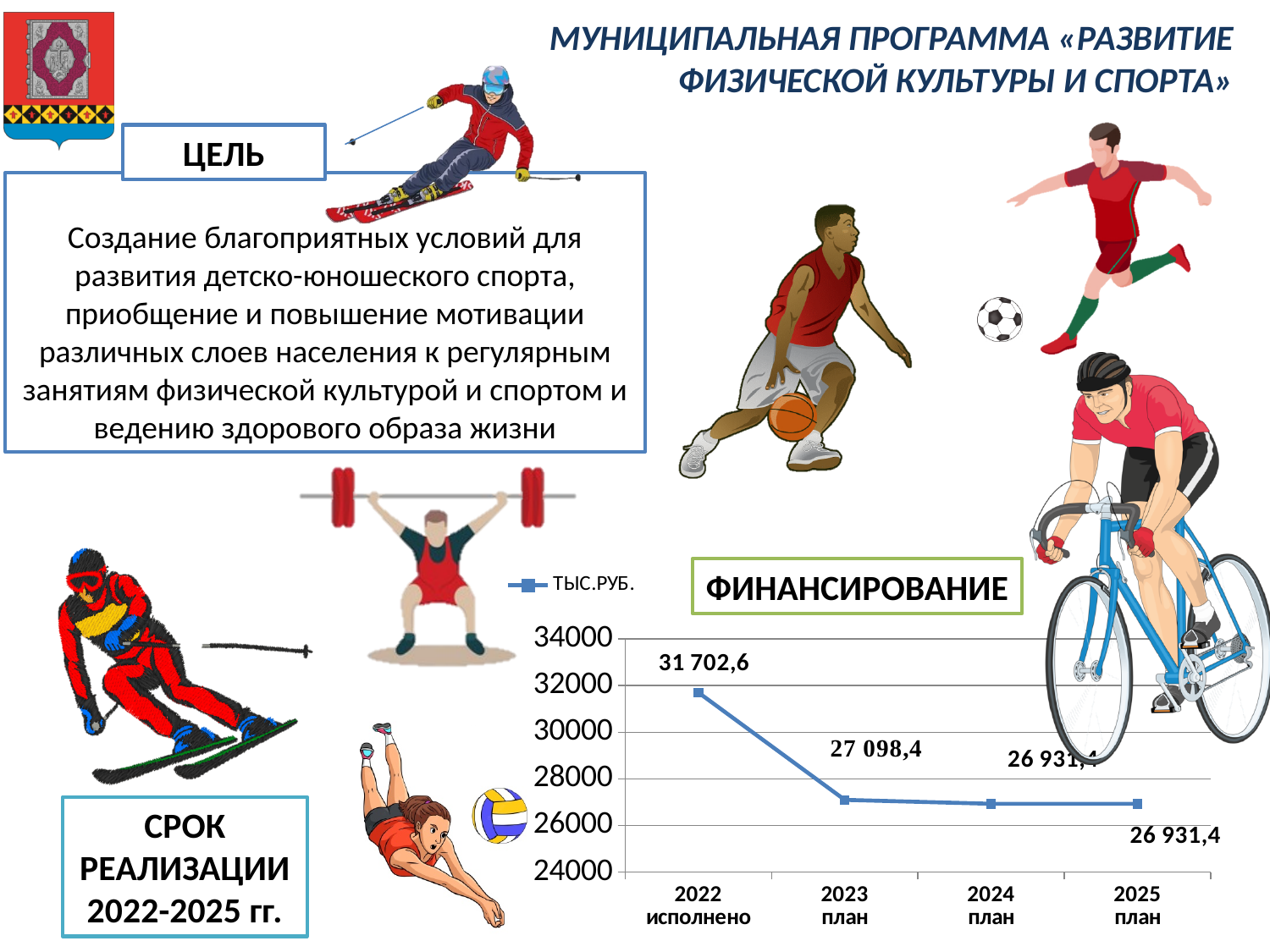
How many categories are shown on the x axis of the financing chart? 4 What is the value for 2022 исполнено in the financing chart? 31 702,6 What is the difference between the values for 2022 исполнено and 2023 план? 4 604,2 Which is larger in the financing chart: the value for 2022 исполнено or 2023 план? 2022 исполнено Is the value for 2024 план greater or less than 28000? less Do the values in the financing chart rise or fall from 2022 to 2025? fall What is the value for 2025 план in the financing chart? 26 931,4 Which category has the highest value in the financing chart? 2022 исполнено What type of chart is shown under the heading ФИНАНСИРОВАНИЕ? Line chart What is the value for 2023 план in the financing chart? 27 098,4 How many series does the legend of the financing chart list? 1 What is the difference between the values for 2023 план and 2025 план? 167,0